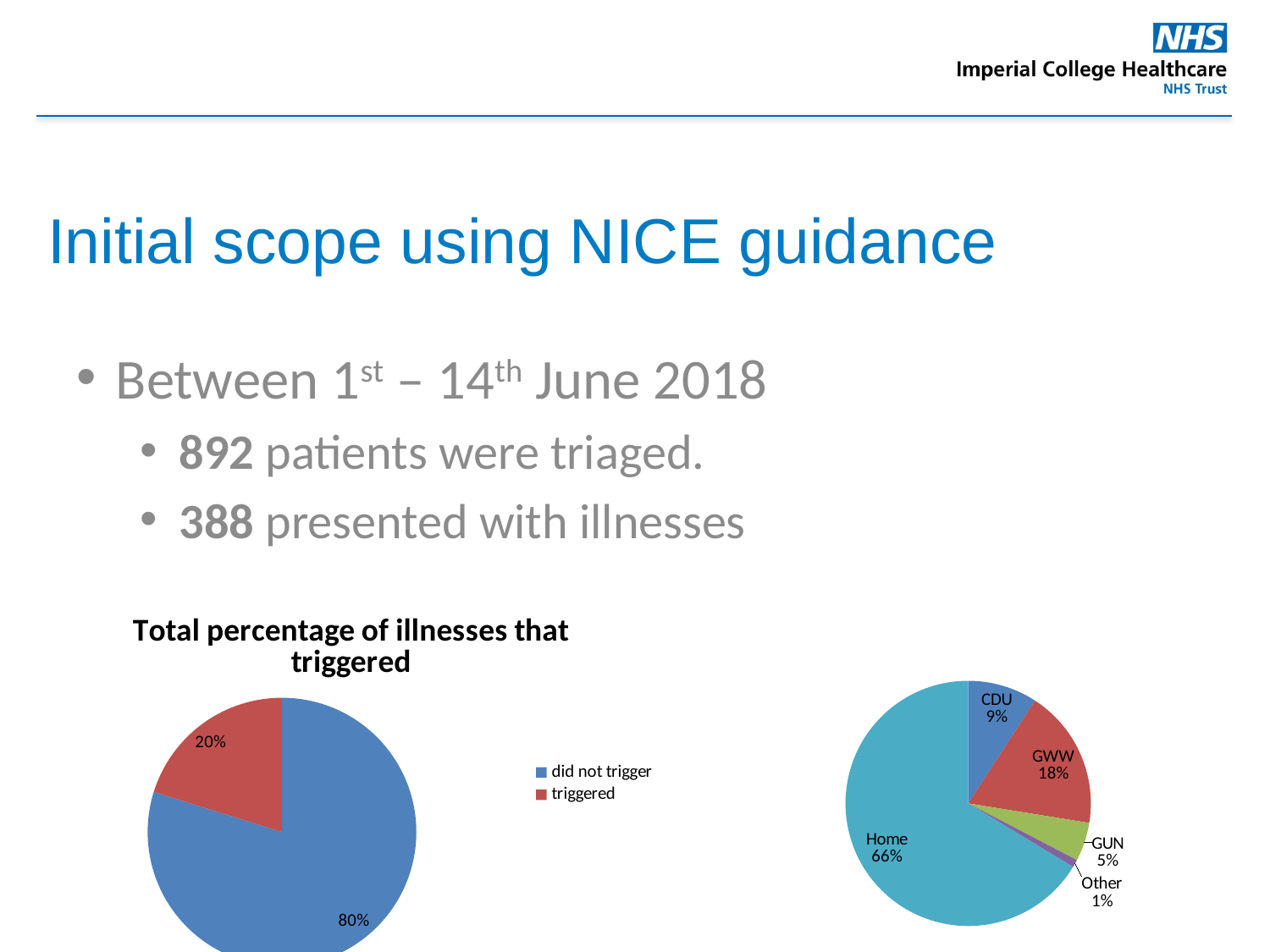
How many slices does the pie chart on the right of the slide have? 5 How many entries does the legend of the chart titled 'Total percentage of illnesses that triggered' list? 2 In the pie chart on the right of the slide, which category has the largest share? Home In the pie chart on the right of the slide, what percentage is labelled 'GWW'? 18% In the pie chart on the right of the slide, what percentage is labelled 'Home'? 66% In the chart titled 'Total percentage of illnesses that triggered', what percentage of illnesses triggered? 20% What kind of chart is the chart titled 'Total percentage of illnesses that triggered'? pie chart In the chart titled 'Total percentage of illnesses that triggered', what percentage of illnesses did not trigger? 80% In the pie chart on the right of the slide, what percentage is labelled 'CDU'? 9% In the chart titled 'Total percentage of illnesses that triggered', which slice is larger, 'did not trigger' or 'triggered'? did not trigger In the chart titled 'Total percentage of illnesses that triggered', what is the difference in percentage points between 'did not trigger' and 'triggered'? 60 In the pie chart on the right of the slide, which category has the smallest share? Other